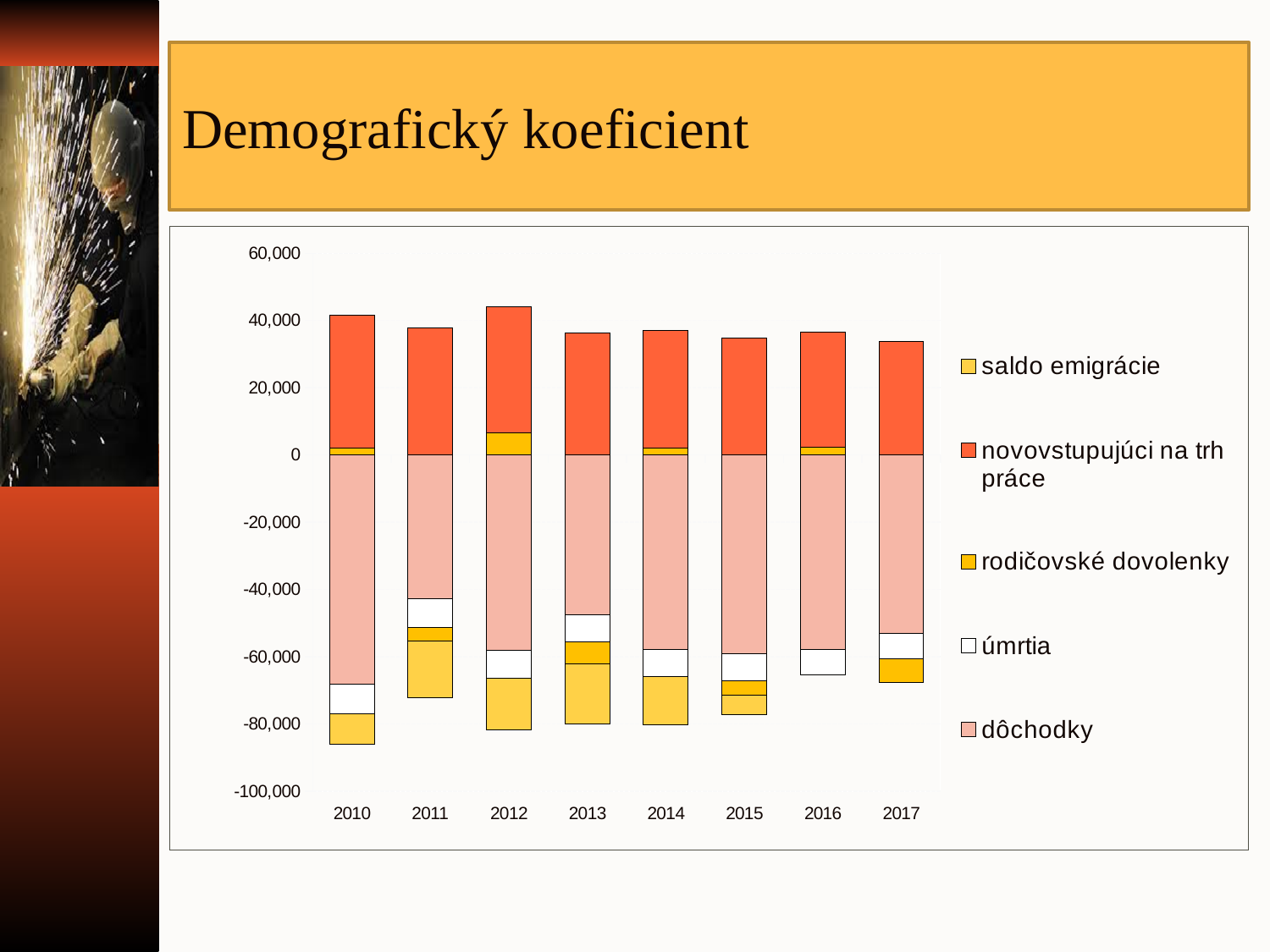
Is the bottom of the stacked bar for 2010 greater or less than -80,000? less What kind of chart is shown on the slide? stacked bar chart What is the title of the slide containing the chart? Demografický koeficient Which year has the highest top of the positive stacked bar? 2012 Which year has the largest positive 'rodičovské dovolenky' segment? 2012 Is the top of the stacked bar for 2017 greater or less than 40,000? less How many years are shown on the x axis of the chart? 8 Which year has the larger positive stacked bar, 2012 or 2017? 2012 Is the bottom of the stacked bar for 2016 greater or less than -80,000? greater How many series does the chart's legend list? 5 Which year's stacked bar extends furthest below zero? 2010